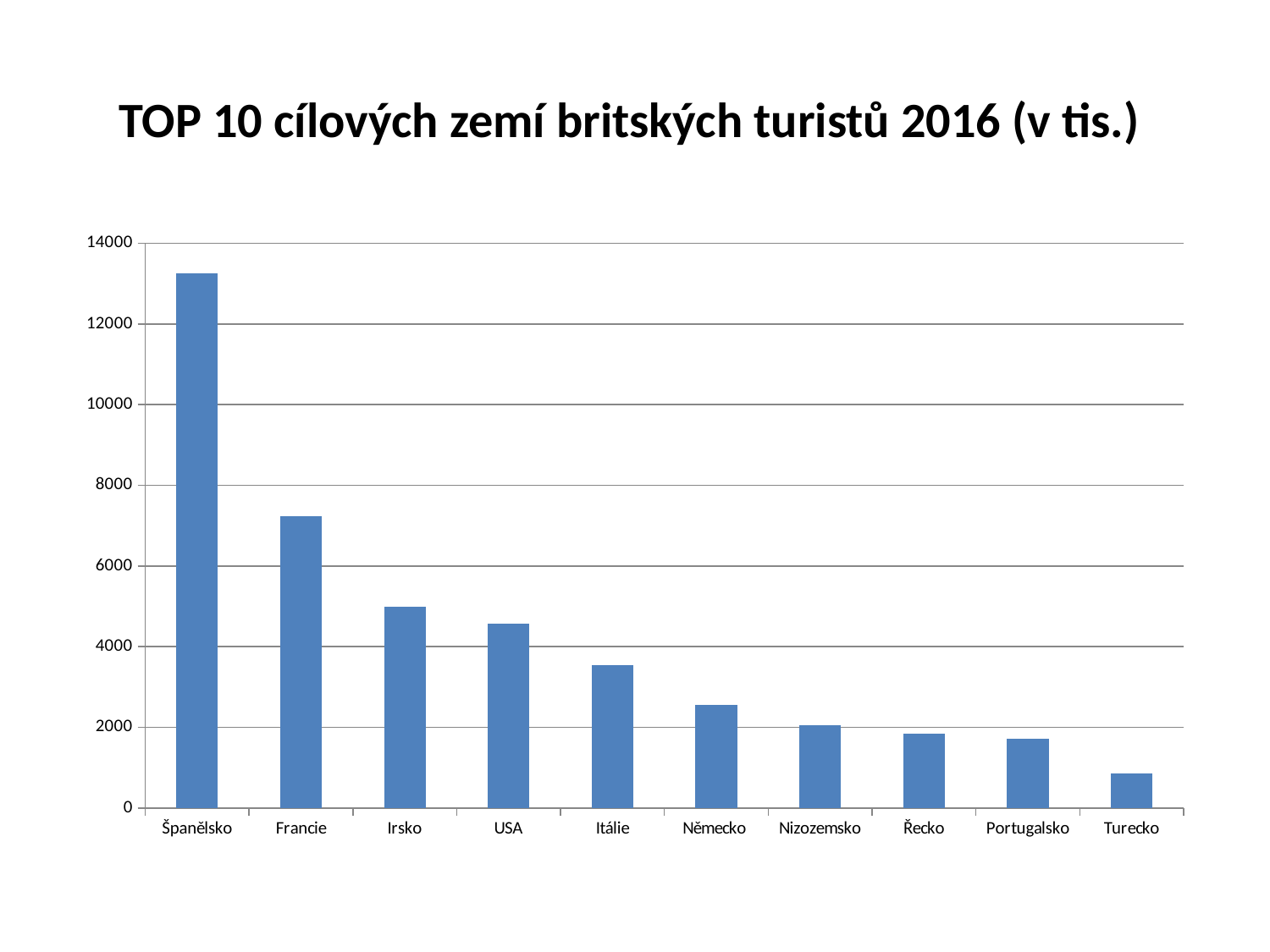
What kind of chart is shown on the slide? bar chart Which country has the highest value in the chart? Španělsko Is the value for Španělsko greater or less than 12000? greater How many countries are shown in the chart? 10 Which has a larger value, Portugalsko or Turecko? Portugalsko Is the value for Itálie greater or less than 4000? less Do the values rise or fall from left to right along the x axis? fall Which country has the lowest value in the chart? Turecko What is the title of the chart? TOP 10 cílových zemí britských turistů 2016 (v tis.) Is the value for Turecko greater or less than 2000? less Which has a larger value, Irsko or USA? Irsko